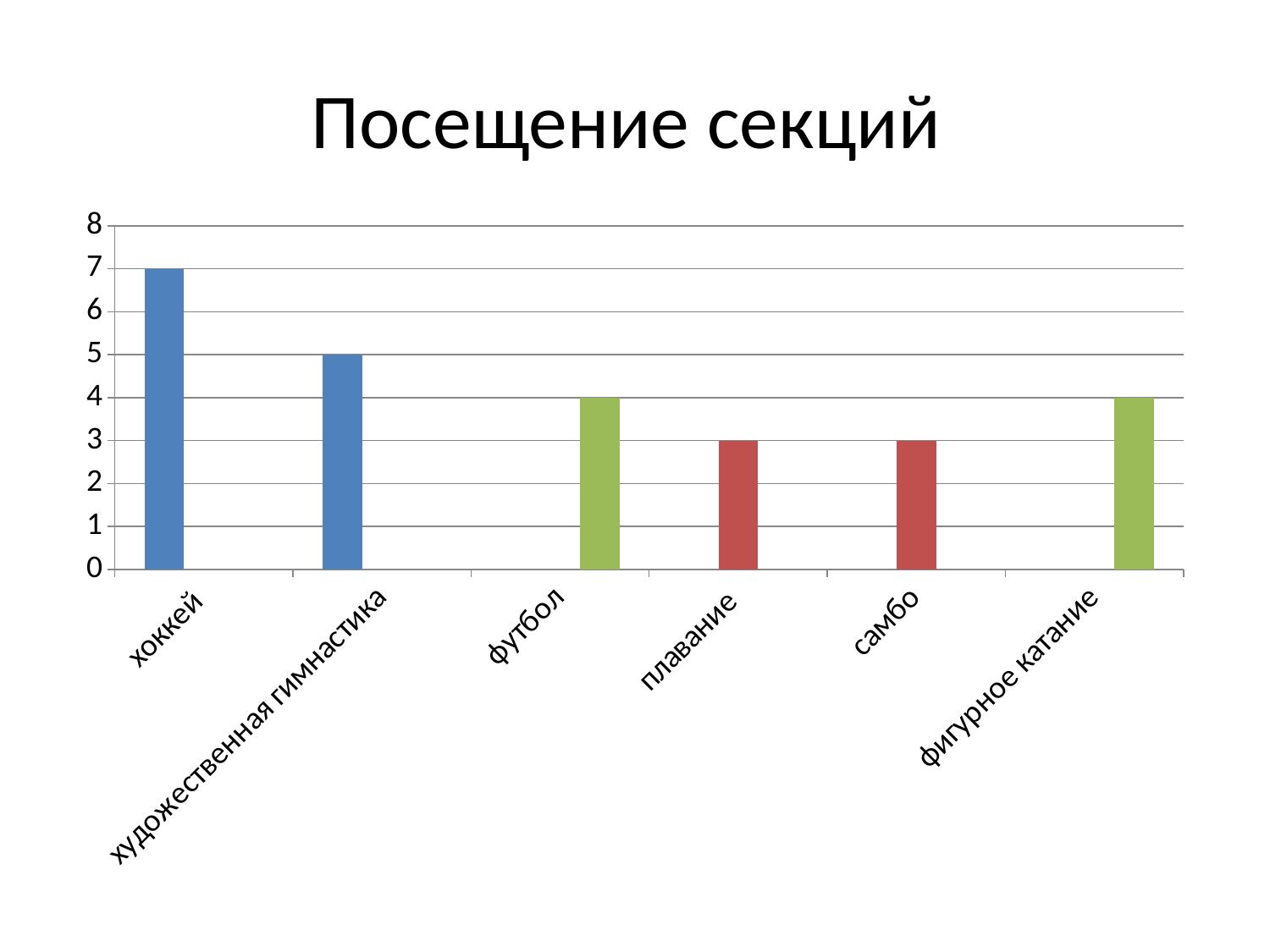
What is the value for плавание? 3 What is the value for художественная гимнастика? 5 What is the value for фигурное катание? 4 What is the difference between the values for хоккей and футбол? 3 What kind of chart is shown on the slide? bar chart What is the title of the slide? Посещение секций Which category has the highest value? хоккей What colour is the bar for самбо? red Is the value for хоккей greater or less than 6? greater How many categories are shown on the x axis? 6 What is the value for хоккей? 7 Which is larger, the value for художественная гимнастика or the value for самбо? художественная гимнастика